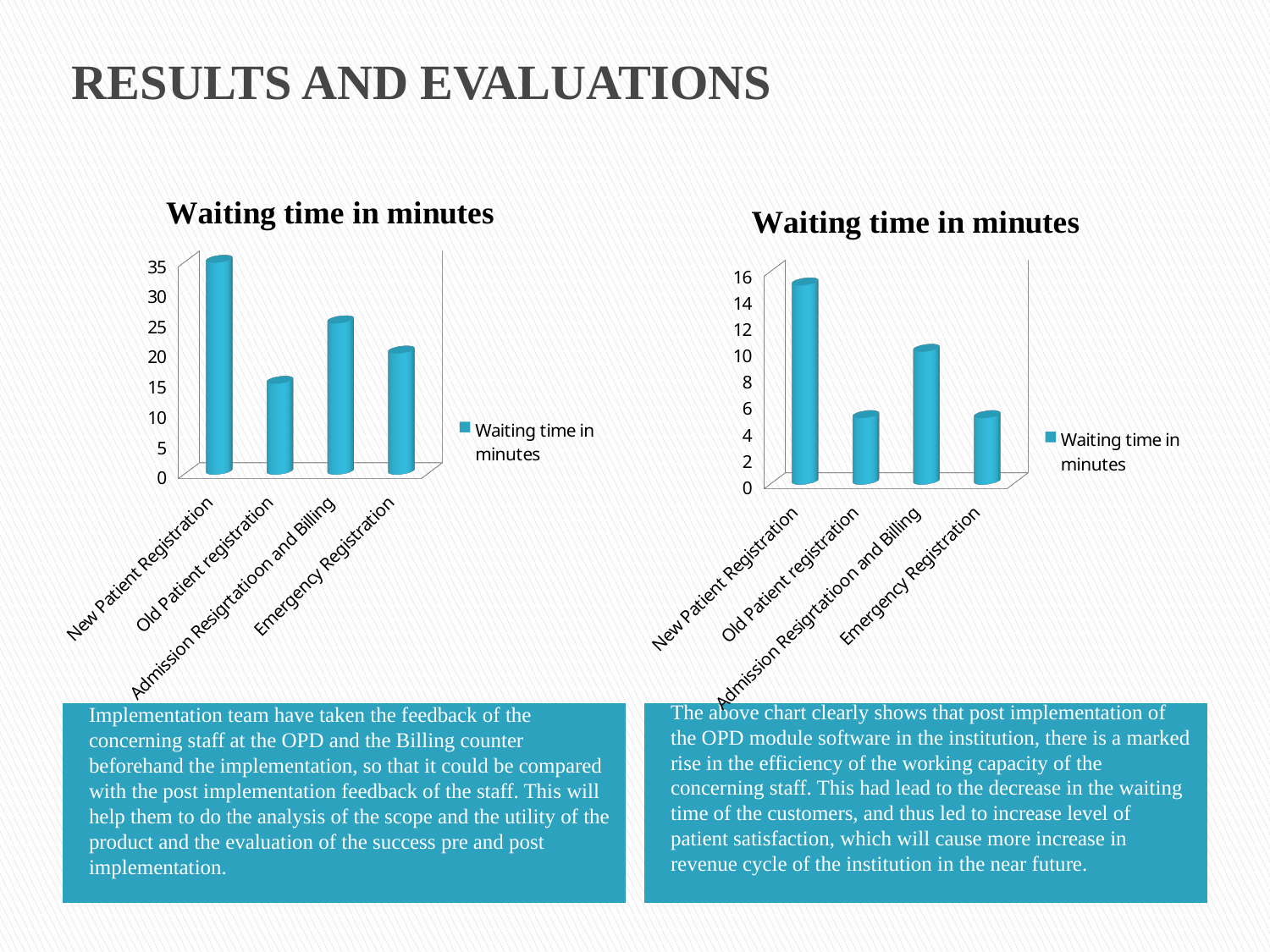
How many series does the legend of the right chart list? 1 In the left chart, which is larger, the value for Admission Resigrtatioon and Billing or the value for Emergency Registration? Admission Resigrtatioon and Billing In the left chart, which category has the lowest waiting time? Old Patient registration In the right chart, which category has the highest waiting time? New Patient Registration In the left chart, is the value for New Patient Registration greater or less than 30? greater In the right chart, is the value for Emergency Registration greater or less than 8? less How many categories does the left chart show? 4 What kind of chart is the left chart on the slide? bar chart In the left chart, which category has the highest waiting time? New Patient Registration What is the title of the right chart? Waiting time in minutes In the left chart, is the value for Old Patient registration greater or less than 20? less